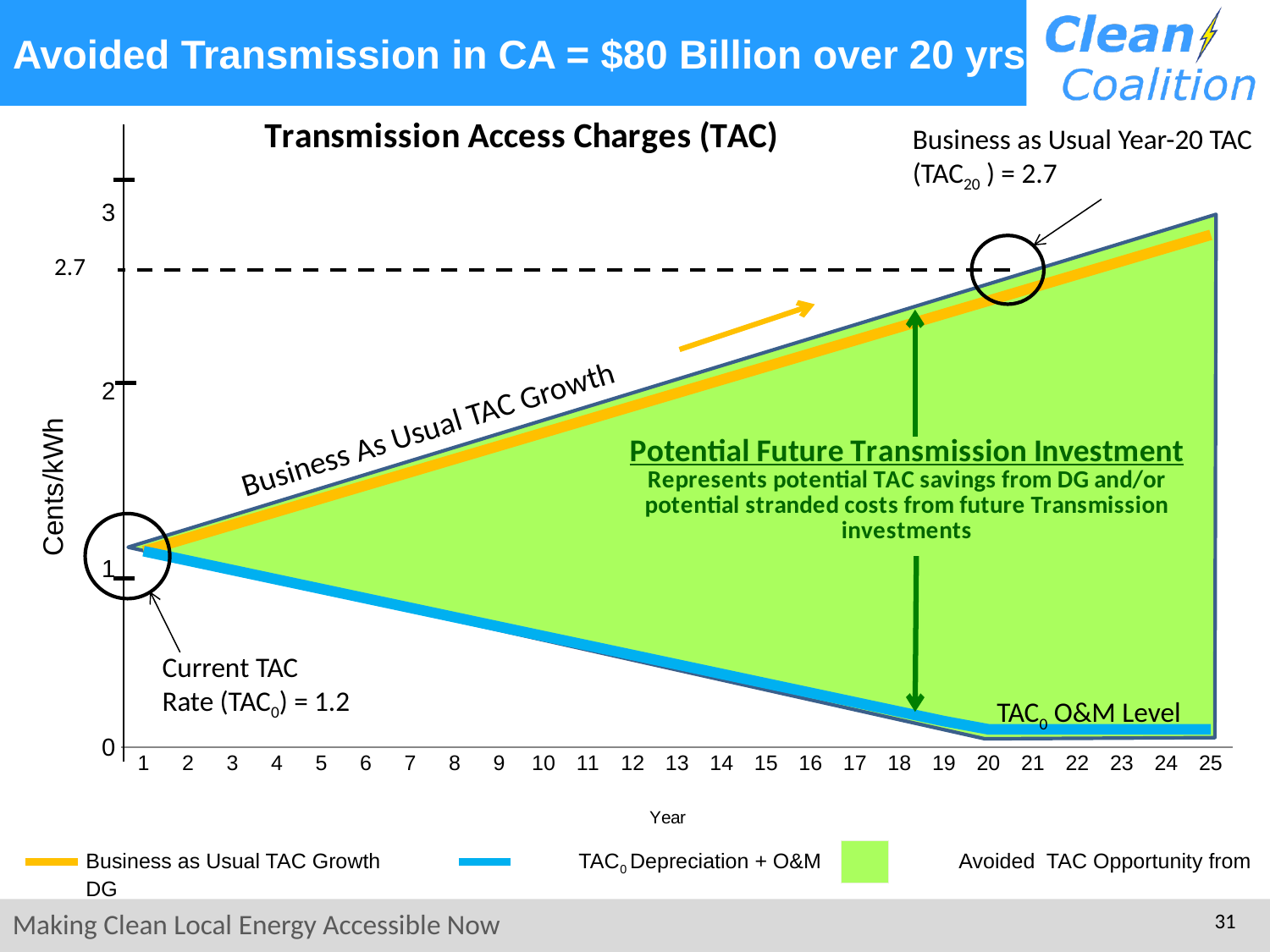
What is the difference between the Business as Usual Year-20 TAC (2.7) and the Current TAC Rate (1.2)? 1.5 How many years are marked along the x axis of the chart? 25 How many series does the chart legend list? 3 Does the TAC0 Depreciation + O&M line rise or fall as the years increase? fall What is the title of the chart? Transmission Access Charges (TAC) What is the Business as Usual Year-20 TAC (TAC20) value shown on the chart? 2.7 At year 20, which is larger: the Business as Usual TAC Growth value or the TAC0 Depreciation + O&M value? Business as Usual TAC Growth Does the Business as Usual TAC Growth line rise or fall as the years increase? rise Is the TAC0 Depreciation + O&M value at year 10 greater or less than 1? less Is the Business as Usual TAC Growth value at year 25 greater or less than 2.7? greater What is the label on the vertical axis of the chart? Cents/kWh What is the Current TAC Rate (TAC0) shown on the chart? 1.2